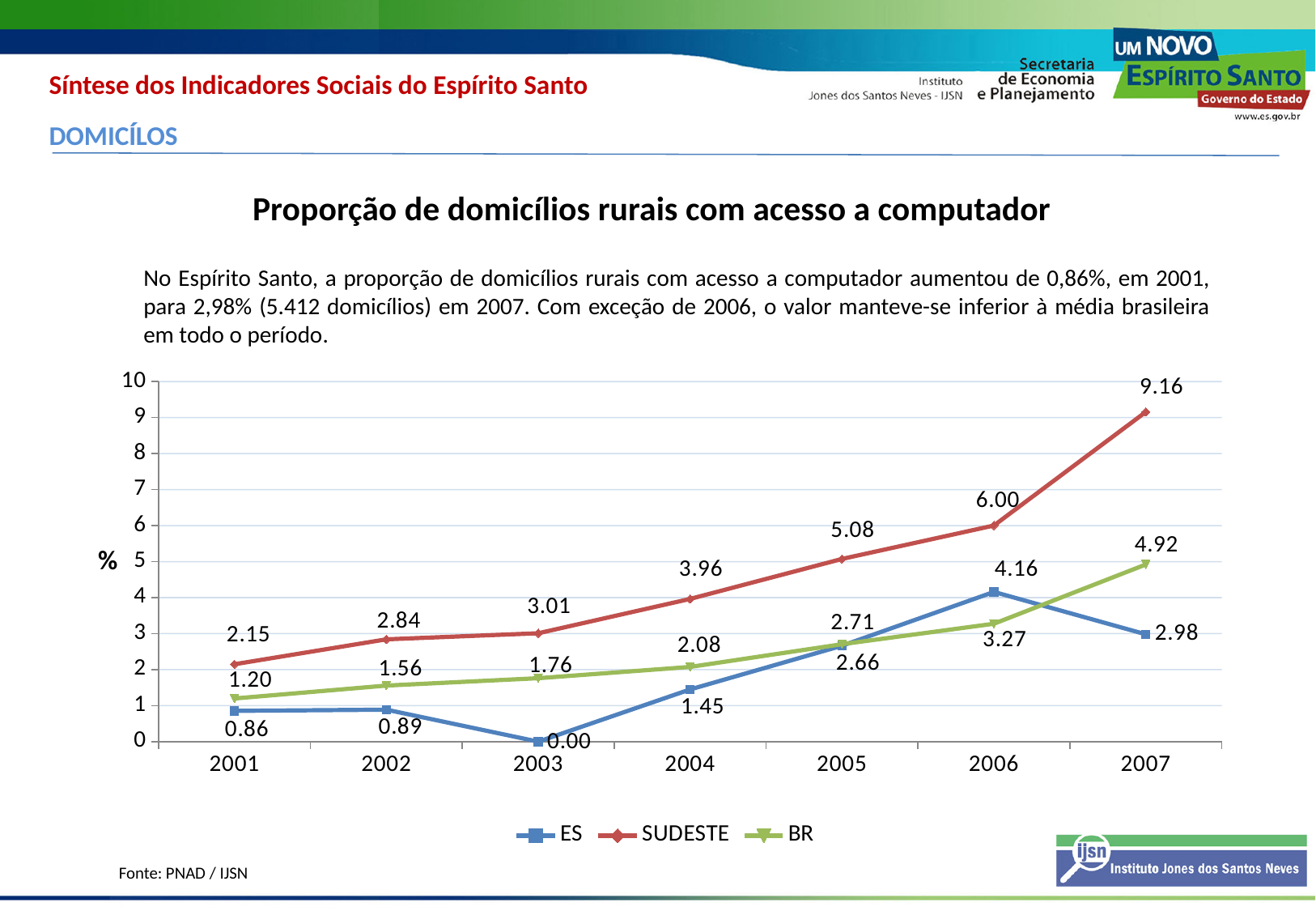
What is the value for BR in 2005? 2.71 What is the difference between the SUDESTE and BR values in 2007? 4.24 In which year does the ES series reach its highest value? 2006 How many years are shown on the x axis? 7 Does the SUDESTE series rise or fall from 2001 to 2007? Rise In 2006, which is larger: the ES value or the BR value? ES What is the title of the chart? Proporção de domicílios rurais com acesso a computador What is the value for ES in 2003? 0.00 In which year is the SUDESTE series lowest? 2001 How many series does the legend list? 3 What is the value for SUDESTE in 2007? 9.16 What type of chart is shown on the slide? Line chart